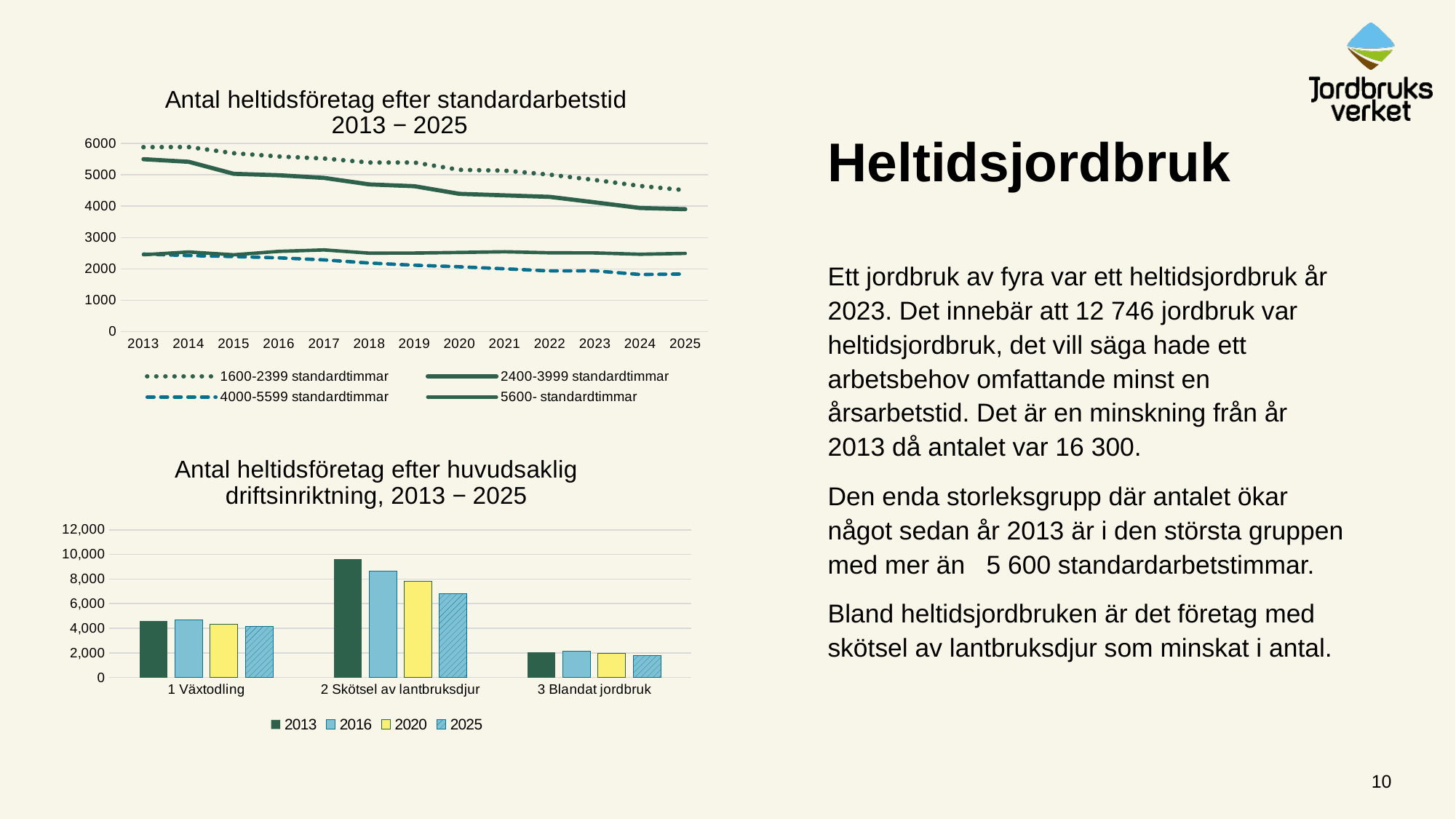
In the top chart, how many years are shown on the x axis? 13 In the top chart, is the value for 1600-2399 standardtimmar in 2025 greater or less than 4000? greater What kind of chart is the top chart, 'Antal heltidsföretag efter standardarbetstid 2013 − 2025'? line chart In the top chart, is the value for 4000-5599 standardtimmar in 2025 greater or less than 2000? less In the top chart, which series has the highest value in 2013? 1600-2399 standardtimmar In the bottom chart, how many series does the legend list? 4 What kind of chart is the bottom chart, 'Antal heltidsföretag efter huvudsaklig driftsinriktning, 2013 − 2025'? bar chart In the bottom chart, is the 2013 value for 2 Skötsel av lantbruksdjur greater or less than 8,000? greater In the top chart, how many series does the legend list? 4 In the bottom chart, which category has the highest bars? 2 Skötsel av lantbruksdjur In the top chart, does the line for 2400-3999 standardtimmar rise or fall from 2013 to 2025? fall In the bottom chart, how many categories are shown on the x axis? 3